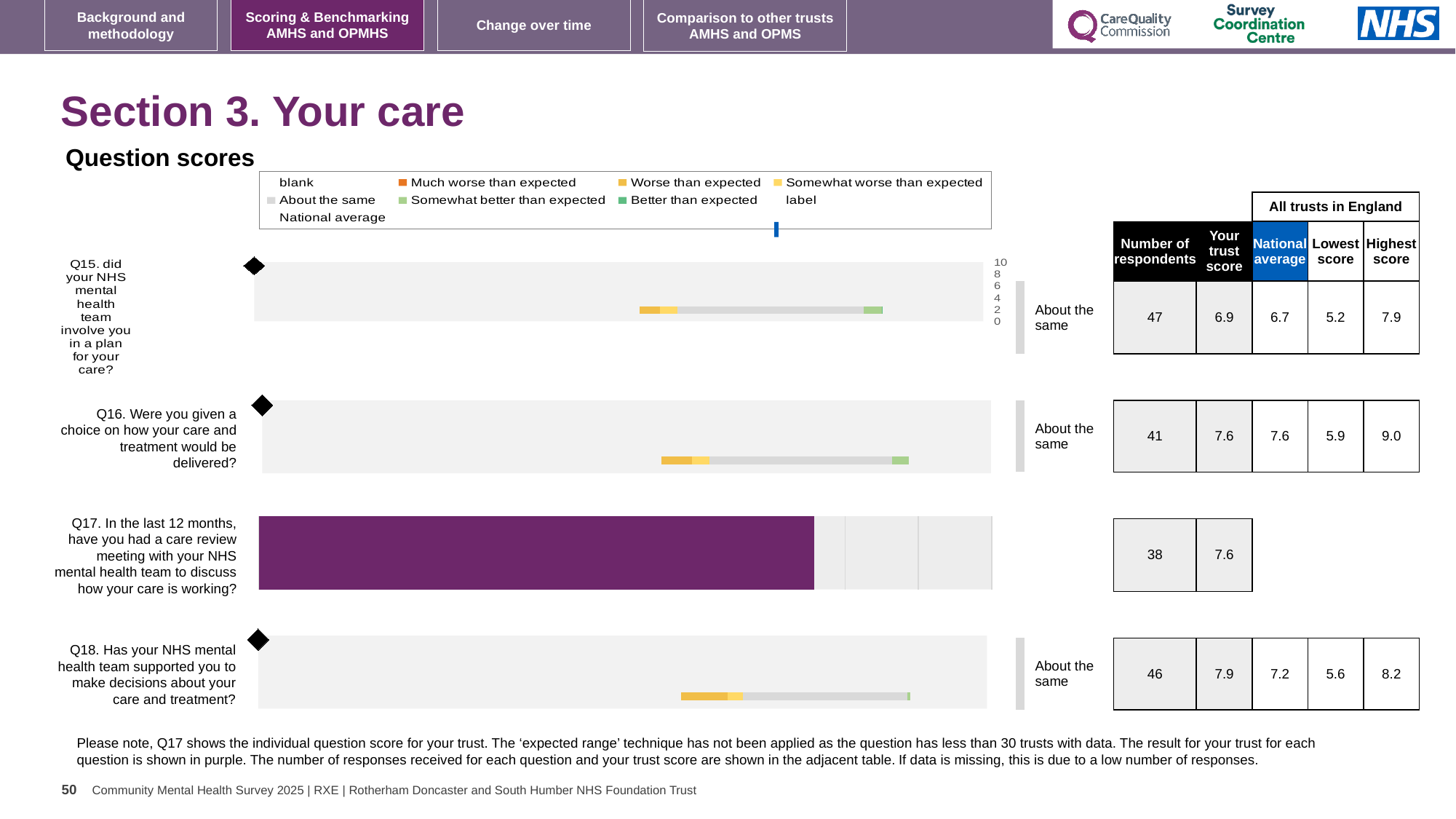
What is the trust score for Q15 (did your NHS mental health team involve you in a plan for your care)? 6.9 Which question has the lowest trust score on this slide? Q15 How many questions are charted on this slide? 4 Which question has the highest trust score on this slide? Q18 What is the benchmark label shown next to the Q16 chart? About the same Is the trust score for Q15 higher or lower than the national average for Q15? higher What is the lowest score among all trusts in England for Q15? 5.2 What is the difference between the trust score and the national average for Q18? 0.7 What kind of chart is used to show the question scores? bar chart What is the highest score among all trusts in England for Q18 (supported you to make decisions about your care and treatment)? 8.2 How many respondents answered Q17 (care review meeting in the last 12 months)? 38 What is the national average for Q16 (were you given a choice on how your care and treatment would be delivered)? 7.6